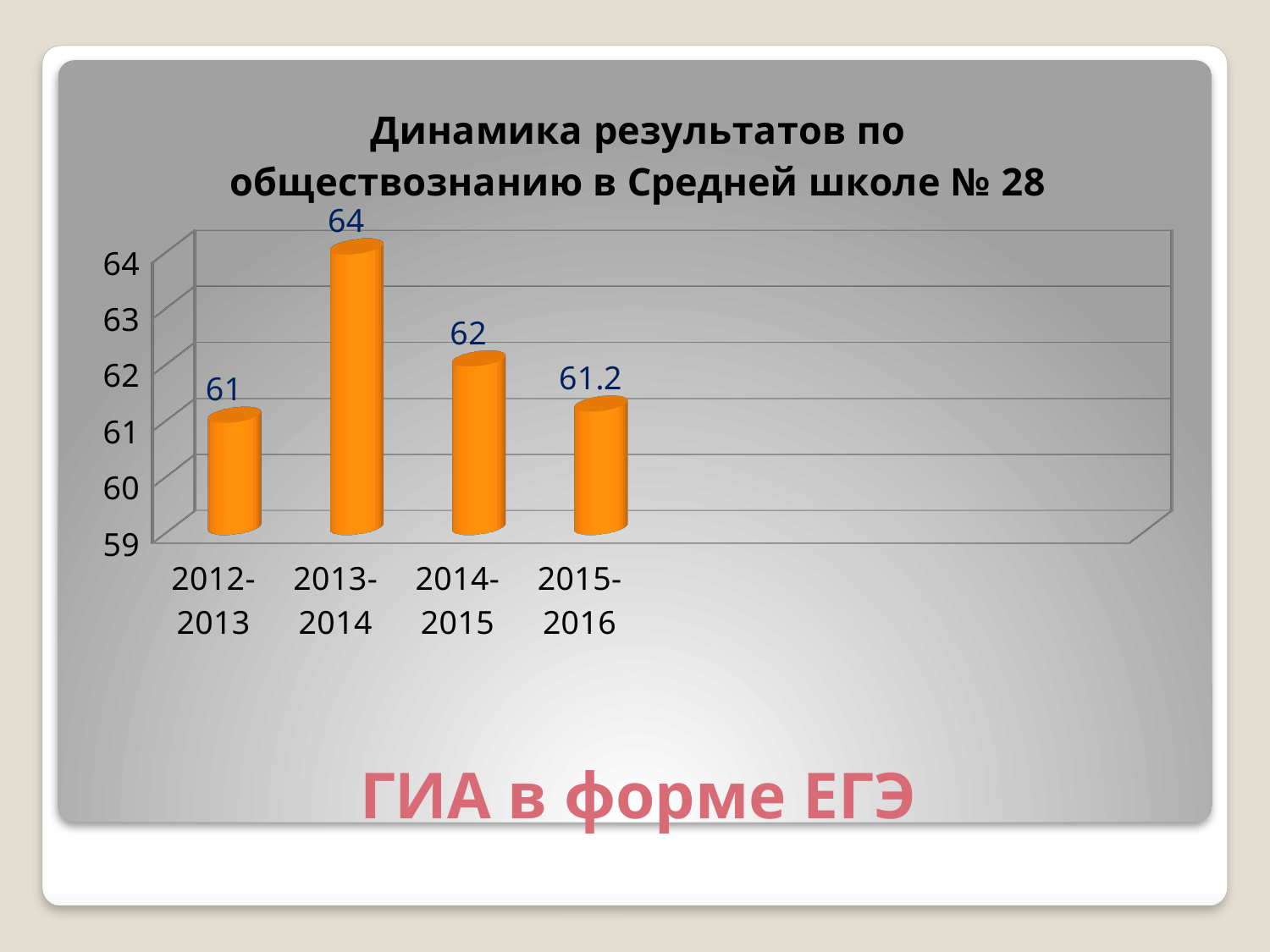
What is the difference between the values for 2013-2014 and 2012-2013? 3 Which school year has the highest value? 2013-2014 What is the value for 2012-2013? 61 What is the title of the chart? Динамика результатов по обществознанию в Средней школе № 28 What is the value for 2013-2014? 64 Which school year has the lowest value? 2012-2013 Which is larger, the value for 2014-2015 or the value for 2015-2016? 2014-2015 What kind of chart is shown on the slide? bar chart What is the value for 2015-2016? 61.2 What is the value for 2014-2015? 62 How many school years are shown on the chart? 4 What is the difference between the values for 2014-2015 and 2015-2016? 0.8